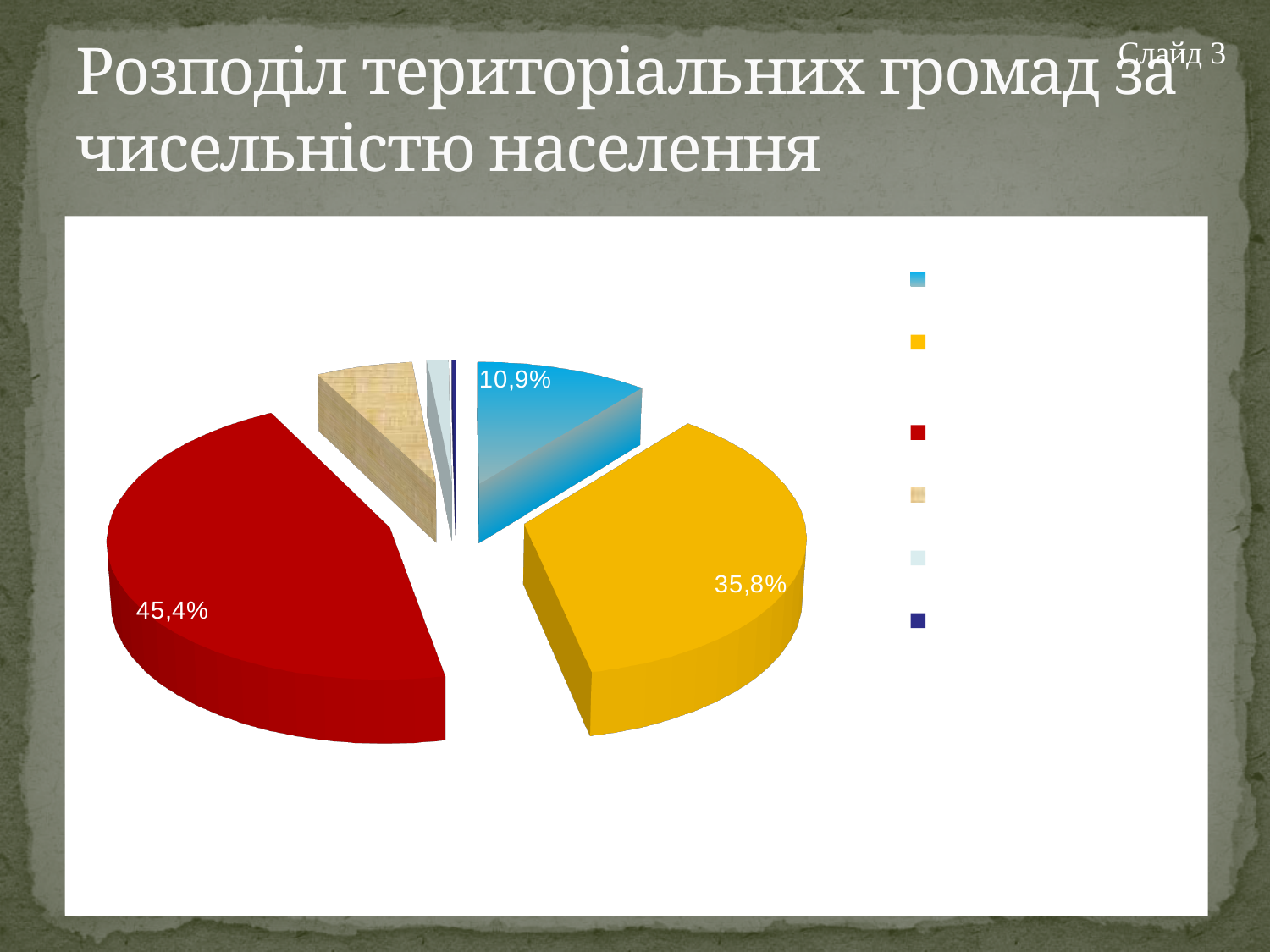
Which slice of the pie chart is the largest? the red slice (45,4%) What is the combined share of the three labelled slices (red, yellow and blue)? 92,1% What kind of chart is shown on the slide? pie chart Which slice of the pie chart is the smallest? the dark blue slice How many slices does the pie chart have? 6 What is the title of the slide containing the chart? Розподіл територіальних громад за чисельністю населення What value is shown on the red slice of the pie chart? 45,4% What value is shown on the blue slice of the pie chart? 10,9% Which is larger, the red slice or the yellow slice? the red slice What value is shown on the yellow slice of the pie chart? 35,8% How many entries does the chart's legend list? 6 By how many percentage points does the red slice exceed the yellow slice? 9,6